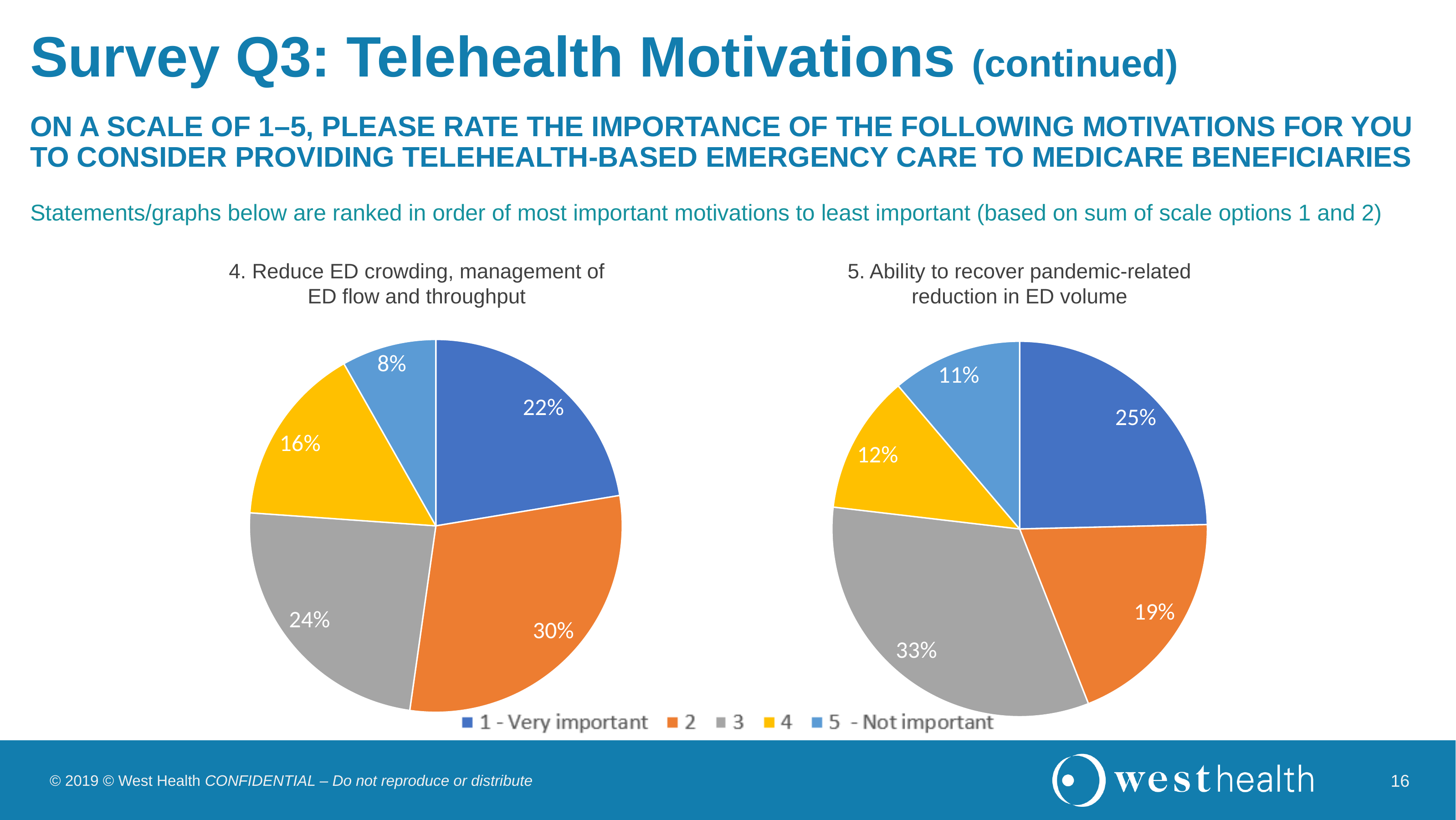
In the right pie chart (5. Ability to recover pandemic-related reduction in ED volume), what share is labelled for '1 - Very important'? 25% In the right pie chart (5. Ability to recover pandemic-related reduction in ED volume), what share is labelled for the '3' slice? 33% How many slices does the left pie chart (4. Reduce ED crowding) have? 5 In the right pie chart (5. Ability to recover pandemic-related reduction in ED volume), which is larger: the '4' slice or the '5 - Not important' slice? 4 How many entries does the shared legend list? 5 In the left pie chart (4. Reduce ED crowding), what is the difference between the '2' slice and the '1 - Very important' slice? 8% In the right pie chart (5. Ability to recover pandemic-related reduction in ED volume), which rating has the smallest slice? 5 - Not important What colour represents '1 - Very important' in the legend? Blue In the left pie chart (4. Reduce ED crowding), which rating has the largest slice? 2 What type of chart is used for '5. Ability to recover pandemic-related reduction in ED volume'? Pie chart In the left pie chart (4. Reduce ED crowding, management of ED flow and throughput), what share is labelled for the '2' slice? 30% In the left pie chart (4. Reduce ED crowding), what share is labelled for '5 - Not important'? 8%